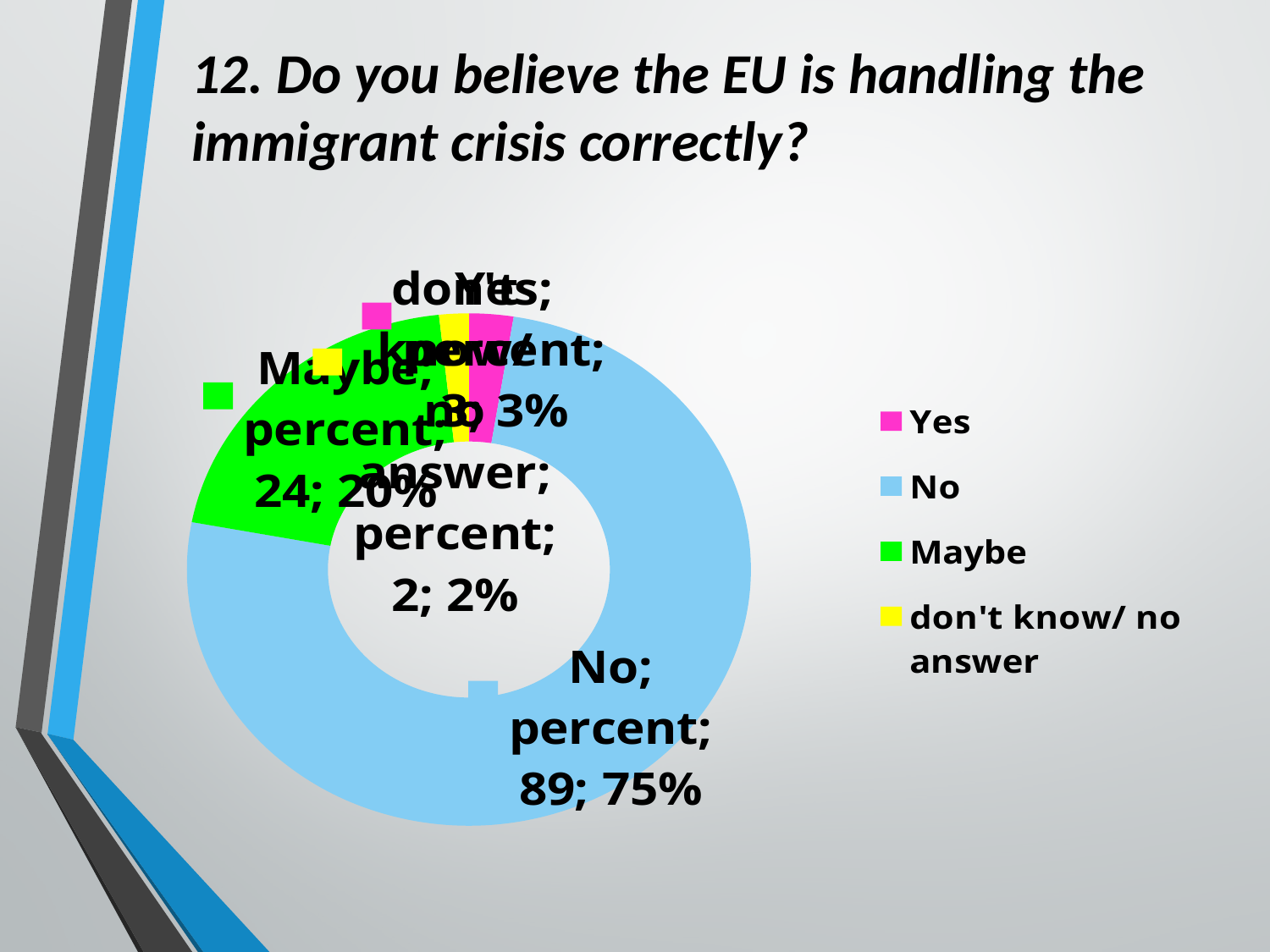
What colour represents "Maybe" in the chart? green How many respondents answered "Maybe"? 24 What percentage of respondents answered "don't know/ no answer"? 2% What percentage of respondents answered "No"? 75% Which answer category has the smallest share of the chart? don't know/ no answer How many entries does the legend list? 4 Which answer category has the largest share of the chart? No What kind of chart is shown on the slide? doughnut chart Which has a larger share, "Maybe" or "Yes"? Maybe How many answer categories are shown in the chart? 4 How many respondents answered "No"? 89 How many more respondents answered "No" than "Maybe"? 65